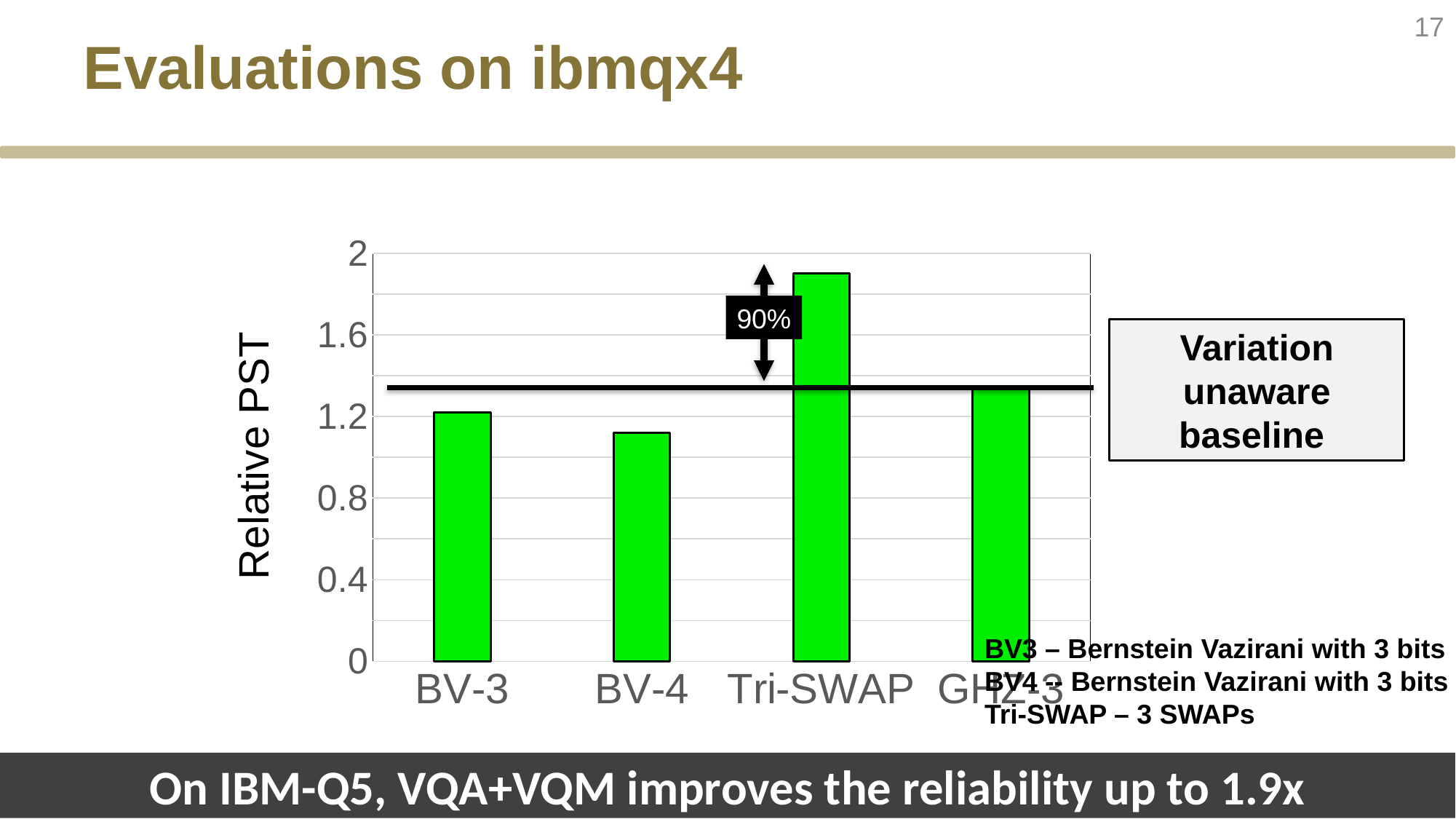
Which category has the highest Relative PST? Tri-SWAP Which has a higher Relative PST, BV-3 or BV-4? BV-3 Which category has the lowest Relative PST? BV-4 Which has a higher Relative PST, Tri-SWAP or GHZ-3? Tri-SWAP Is the Relative PST for GHZ-3 greater or less than 1.6? less What kind of chart is shown on the slide? bar chart Is the Relative PST for Tri-SWAP greater or less than 1.6? greater What percentage is shown in the annotation above the Tri-SWAP bar? 90% Is the Relative PST for BV-4 greater or less than 1.2? less What is the label on the y axis of the chart? Relative PST How many categories are plotted on the x axis of the chart? 4